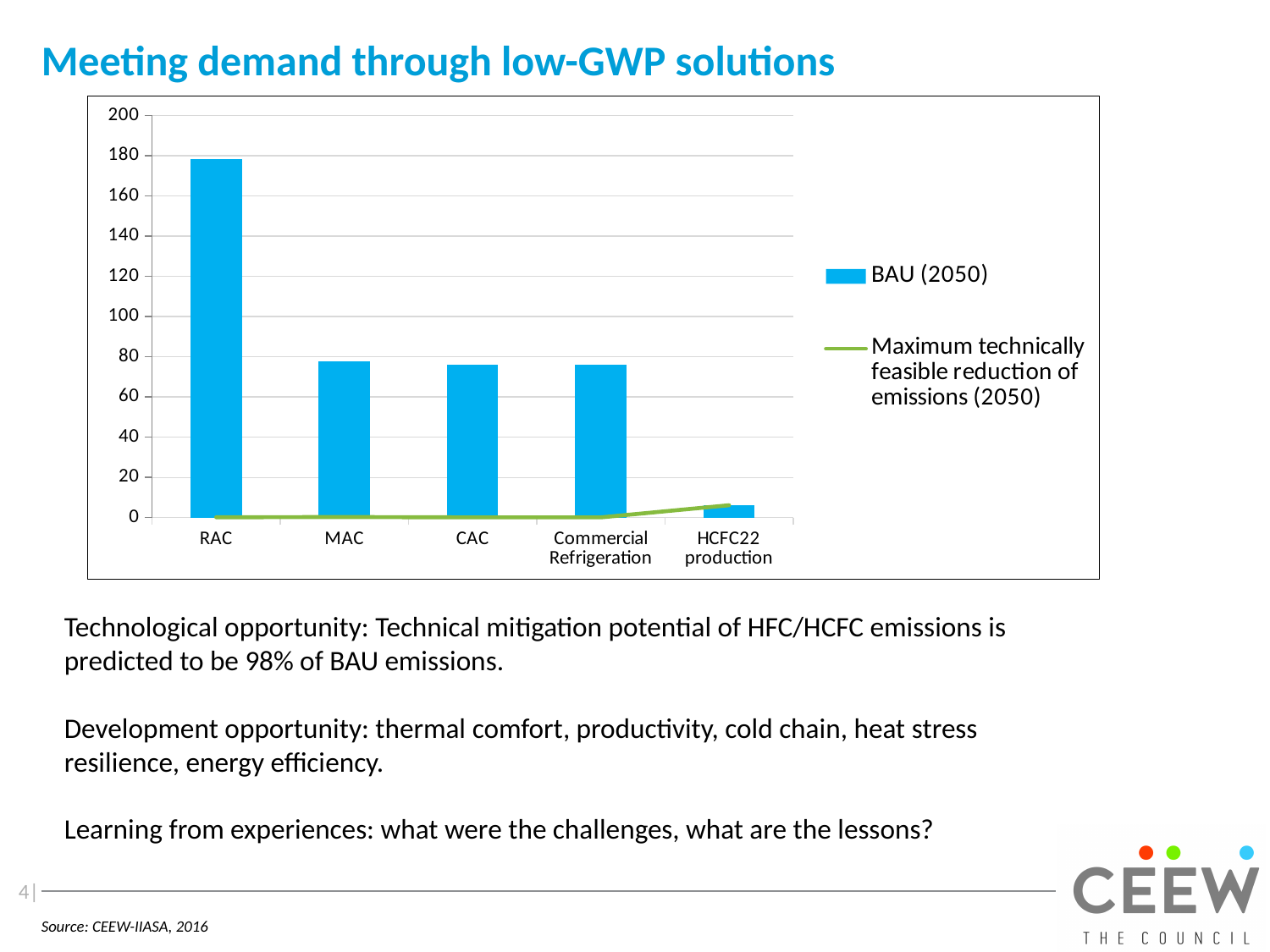
What colour are the BAU (2050) bars in the chart? Blue Which category has the lowest BAU (2050) value? HCFC22 production Is the BAU (2050) value for HCFC22 production greater or less than 20? less Which has a larger BAU (2050) value, RAC or CAC? RAC Is the BAU (2050) value for CAC greater or less than 60? greater Is the BAU (2050) value for RAC greater or less than 160? greater Which has a larger BAU (2050) value, Commercial Refrigeration or HCFC22 production? Commercial Refrigeration Which category has the highest BAU (2050) value? RAC How many series does the chart legend list? 2 What kind of chart is shown on the slide? Combination bar and line chart How many categories are shown on the x axis of the chart? 5